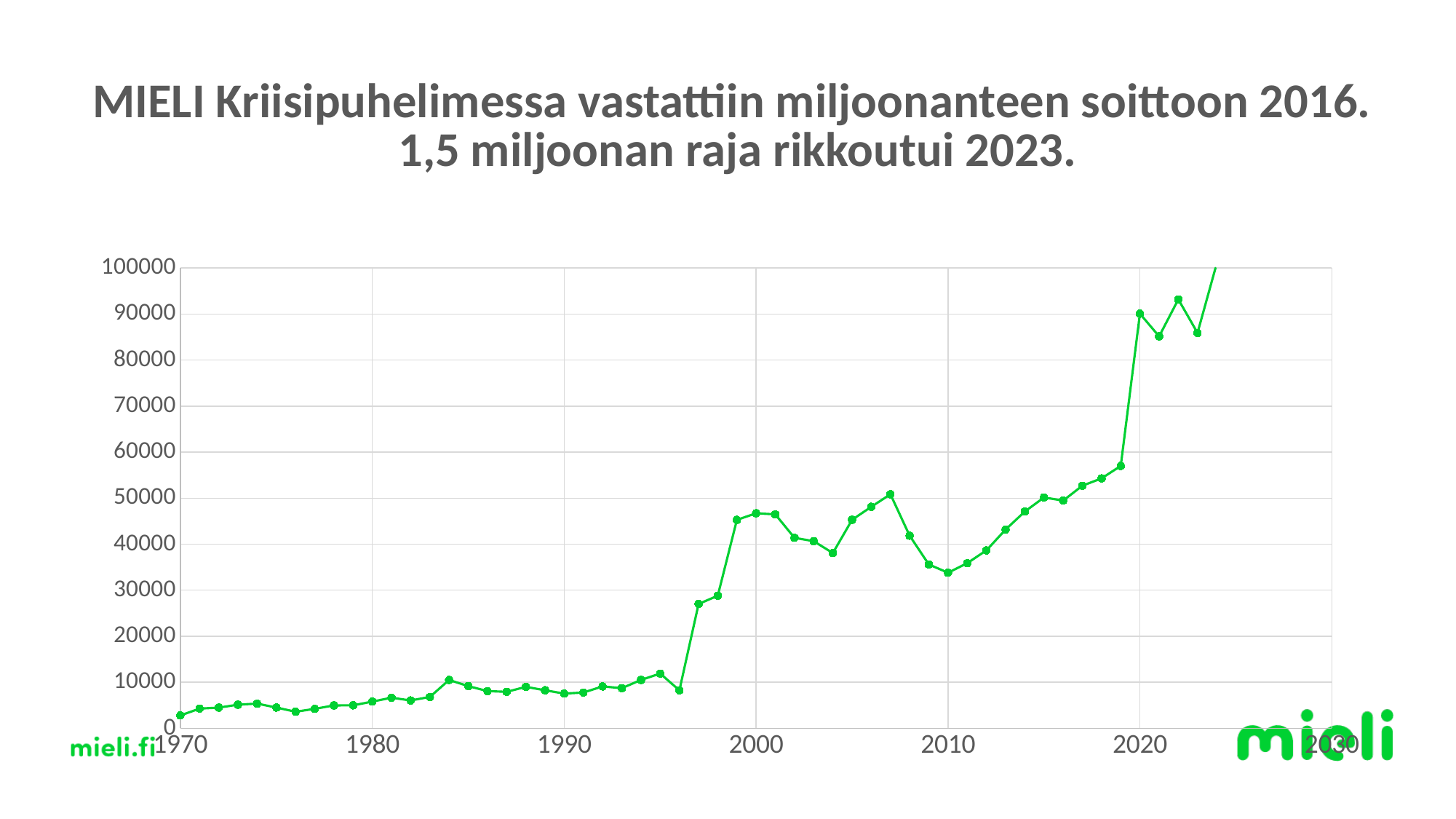
Is the value for 2010 greater or less than 40000? less Which year has the higher value, 2000 or 2010? 2000 Which year has the higher value, 2019 or 2020? 2020 Is the value for 2010 greater or less than 30000? greater Is the value for 1996 greater or less than 10000? less What colour is the plotted line? green What kind of chart is shown on the slide? line chart Do the values rise or fall between 2007 and 2010? fall Do the values generally rise or fall from 1970 to the end of the series? rise